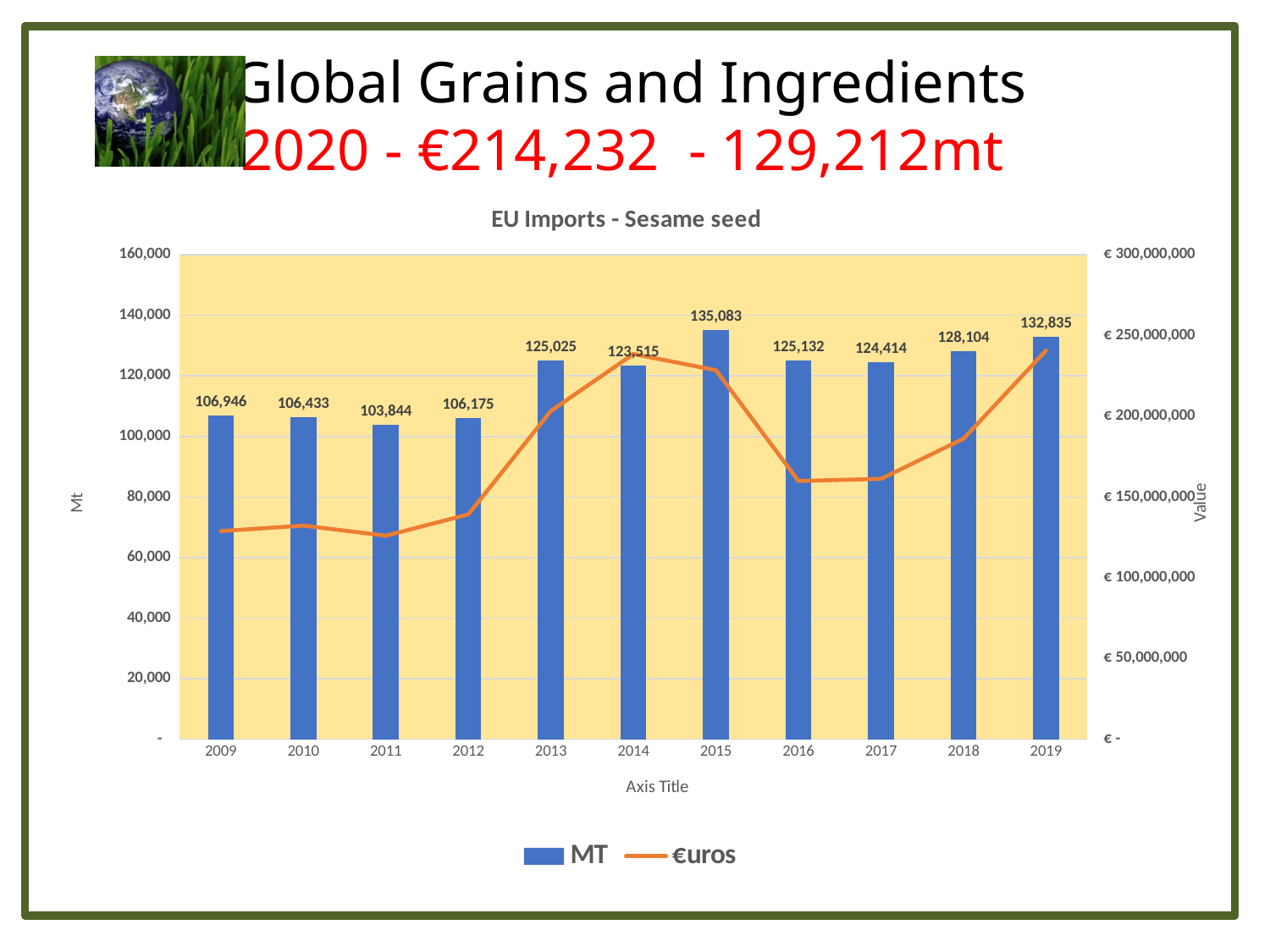
What is the difference in MT between 2019 and 2018 in the EU Imports - Sesame seed chart? 4,731 What is the MT value for 2019 in the EU Imports - Sesame seed chart? 132,835 Is the €uros value for 2009 greater or less than € 150,000,000? less What is the MT value for 2015 in the EU Imports - Sesame seed chart? 135,083 How many years are shown on the x axis of the EU Imports - Sesame seed chart? 11 Which year has the lowest MT value in the EU Imports - Sesame seed chart? 2011 What is the MT value for 2011 in the EU Imports - Sesame seed chart? 103,844 Is the €uros value for 2019 greater or less than € 200,000,000? greater How many series does the legend of the EU Imports - Sesame seed chart list? 2 Which year has the larger MT value, 2013 or 2014? 2013 Does the €uros line rise or fall from 2016 to 2019? rise Which year has the highest MT value in the EU Imports - Sesame seed chart? 2015